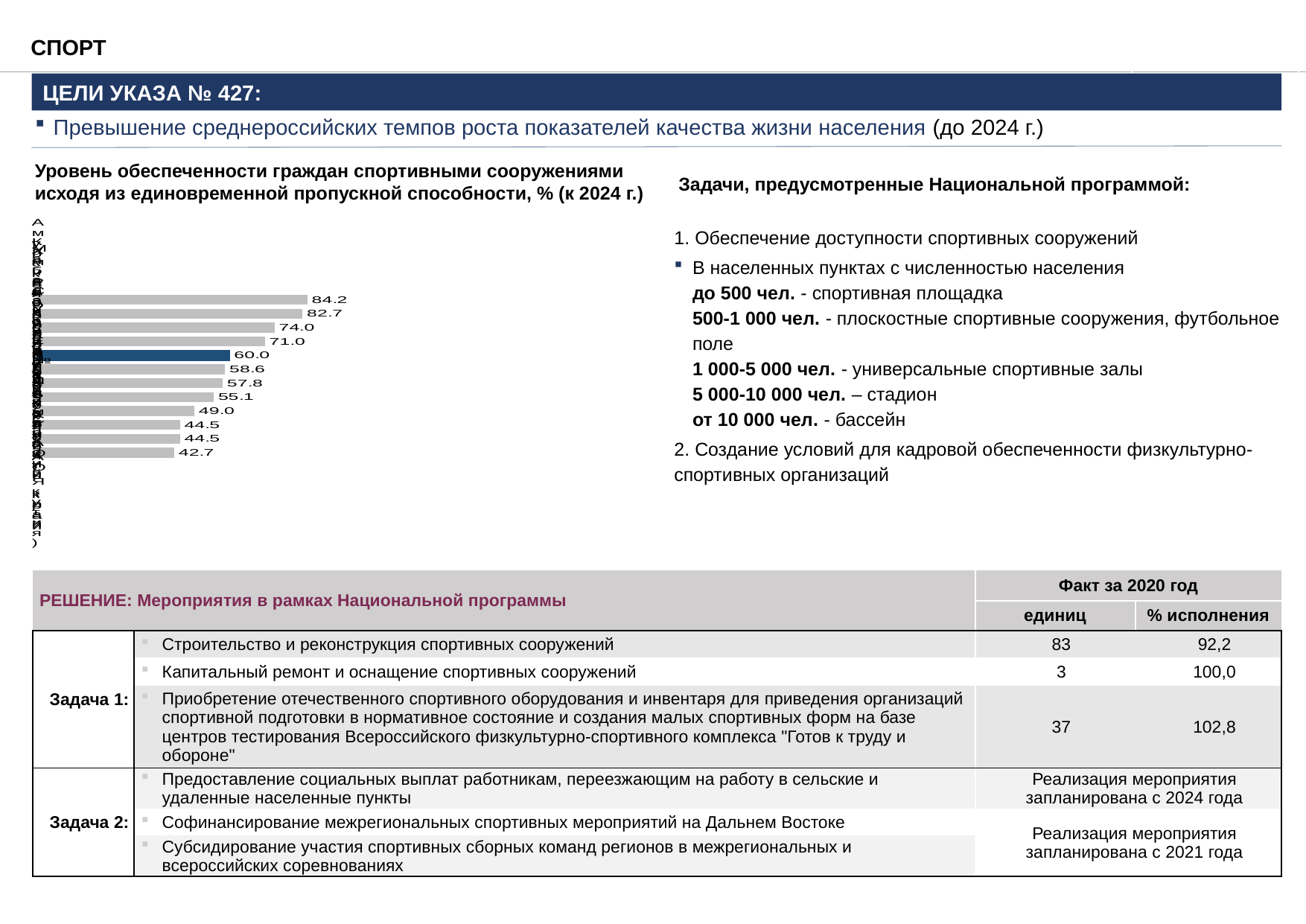
How many bars in the chart are labelled 44.5? 2 What unit is stated in the chart title for the values plotted? % What is the second highest value labelled in the bar chart? 82.7 What is the highest value shown in the bar chart? 84.2 By how much does the highest bar (84.2) exceed the blue highlighted bar (60.0)? 24.2 How many bars are plotted in the chart on the left? 12 What value is labelled on the blue highlighted bar in the chart? 60.0 What is the lowest value shown in the bar chart? 42.7 Do the bar values increase or decrease going from the top bar to the bottom bar? decrease How many bars in the chart have values above 70? 4 What is the difference between the highest and lowest values in the bar chart? 41.5 What kind of chart is shown on the left of the slide? bar chart